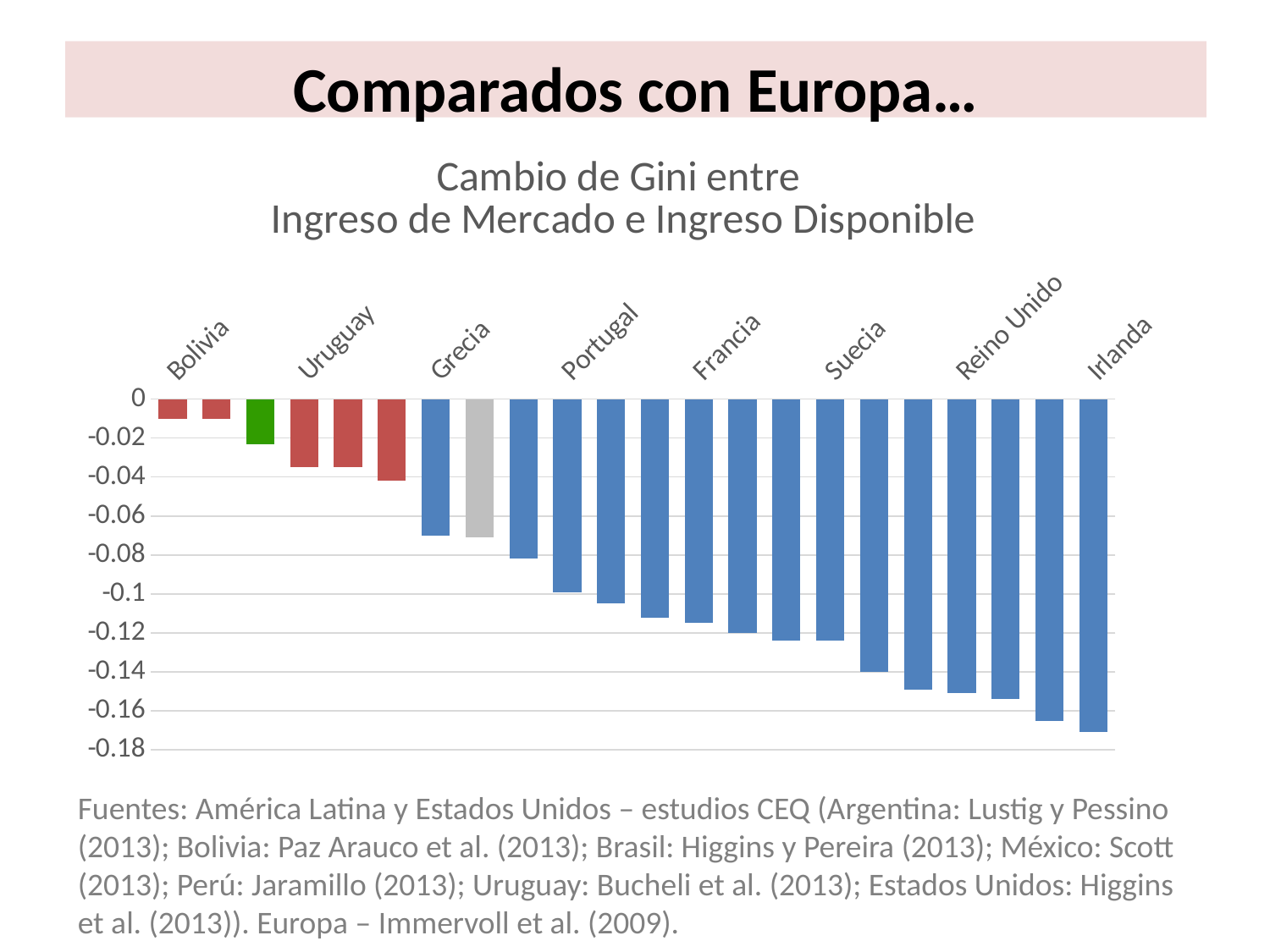
Is the value for Francia greater or less than -0.1? less What is the title of the chart? Cambio de Gini entre Ingreso de Mercado e Ingreso Disponible How many bars are plotted in the chart? 22 What colour is the bar for Uruguay? red Which has the higher (less negative) value, Grecia or Francia? Grecia Do the values generally rise or fall moving from left to right along the x axis? fall What kind of chart is shown on the slide? bar chart Is the value for Bolivia greater or less than -0.02? greater Which labeled country has the lowest (most negative) value in the chart? Irlanda Is the value for Irlanda greater or less than -0.16? less